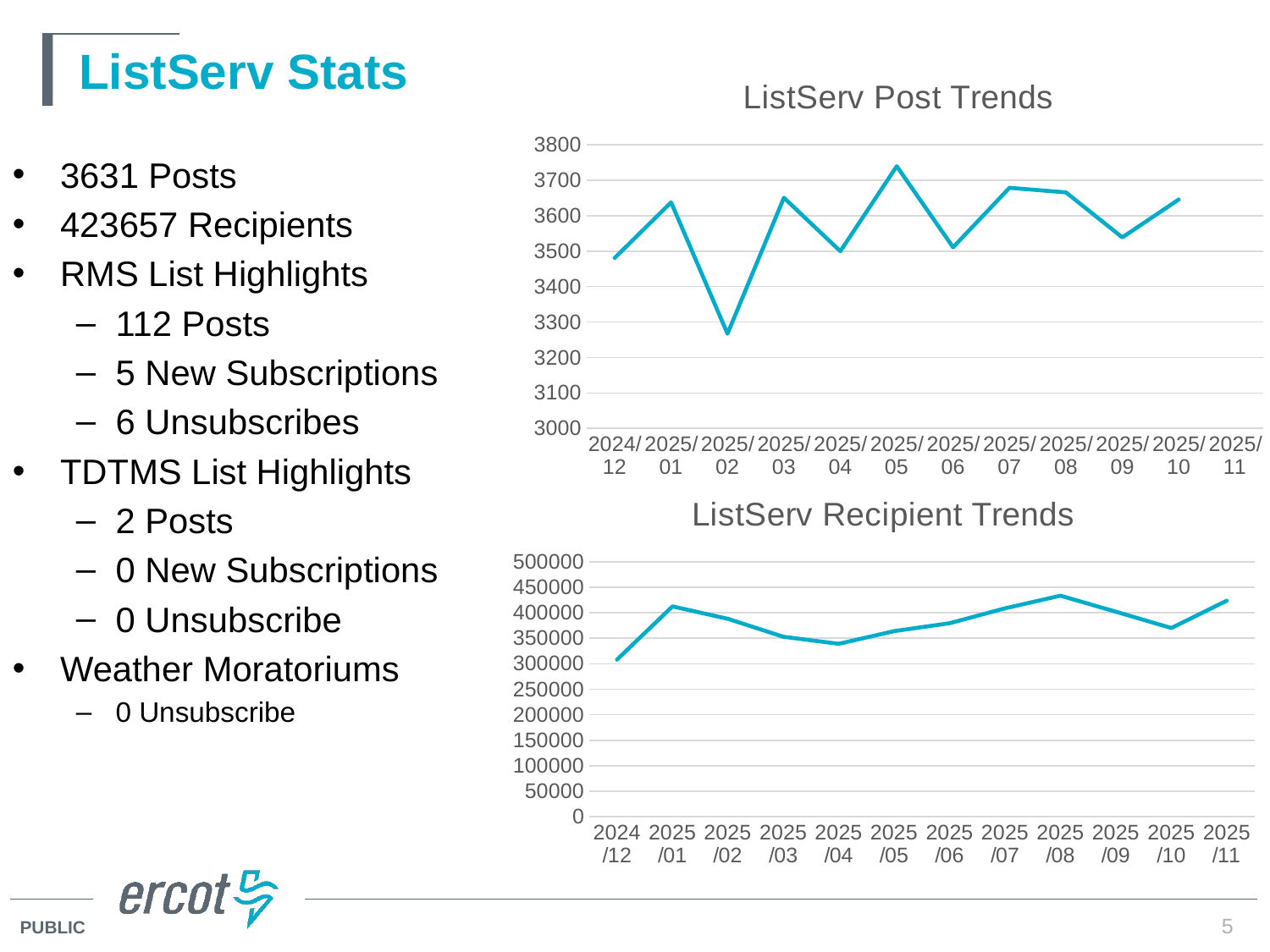
In the ListServ Post Trends chart, is the value for 2024/12 greater or less than 3500? less What kind of chart is the ListServ Recipient Trends chart? line chart In the ListServ Post Trends chart, which is larger, the value for 2025/03 or the value for 2025/04? 2025/03 In the ListServ Post Trends chart, is the value for 2025/05 greater or less than 3700? greater In the ListServ Recipient Trends chart, which month has the lowest value? 2024/12 In the ListServ Post Trends chart, which month has the lowest value? 2025/02 In the ListServ Post Trends chart, which month has the highest value? 2025/05 In the ListServ Recipient Trends chart, which is larger, the value for 2025/01 or the value for 2025/04? 2025/01 What kind of chart is the ListServ Post Trends chart? line chart In the ListServ Post Trends chart, is the value for 2025/02 greater or less than 3300? less In the ListServ Post Trends chart, does the value rise or fall from 2025/01 to 2025/02? fall